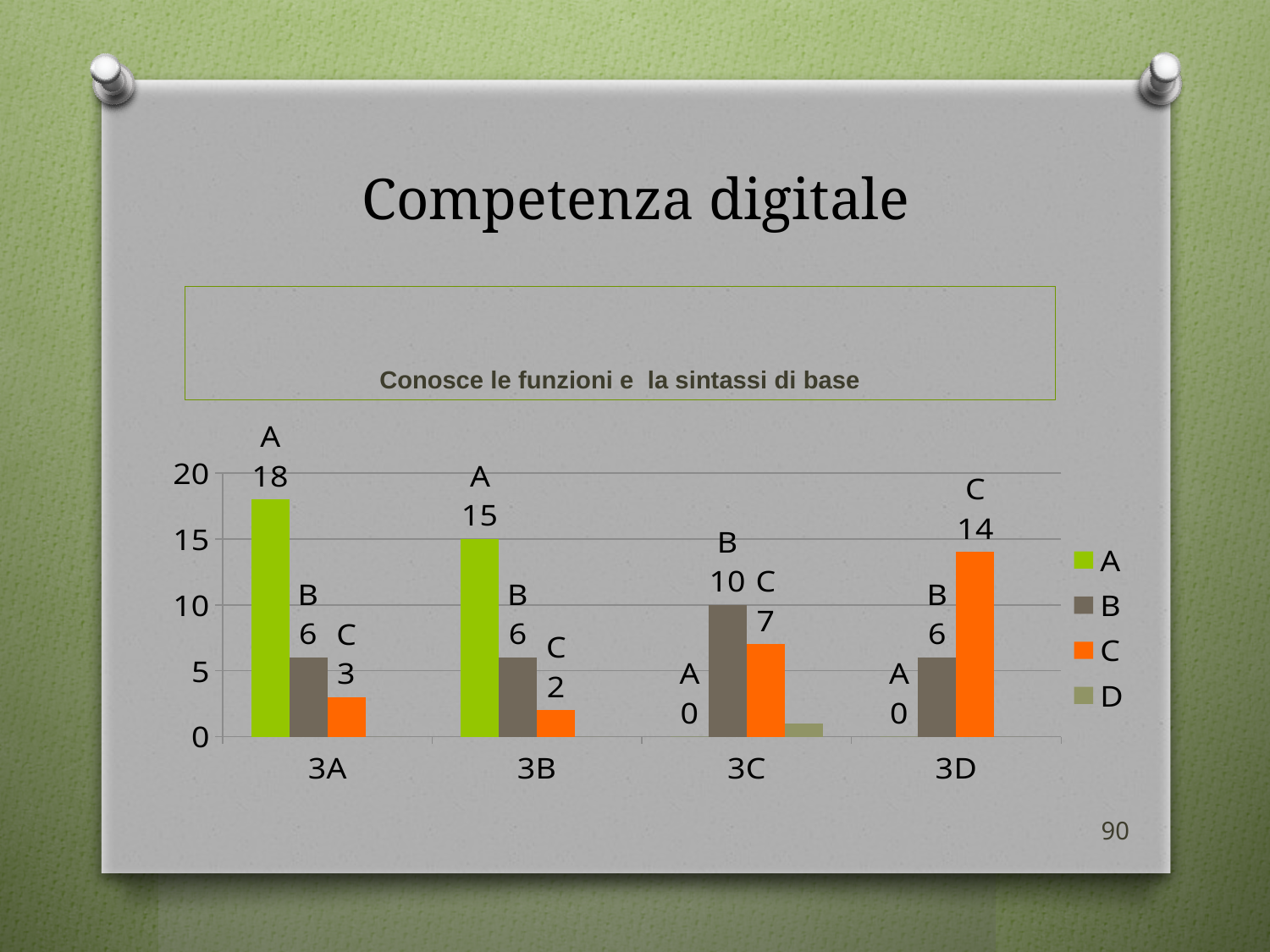
Is the value of series D for class 3C greater or less than 5? less What is the value of series A for class 3C? 0 Which is larger: series C for 3C or series C for 3D? 3D What is the difference between the series A values for 3A and 3B? 3 What is the value of series B for class 3C? 10 Which class has the highest value for series A? 3A Which class has the lowest value for series C? 3B What is the value of series C for class 3D? 14 How many classes are shown on the x axis? 4 What is the value of series A for class 3A? 18 What kind of chart is shown on the slide? bar chart How many series does the legend list? 4